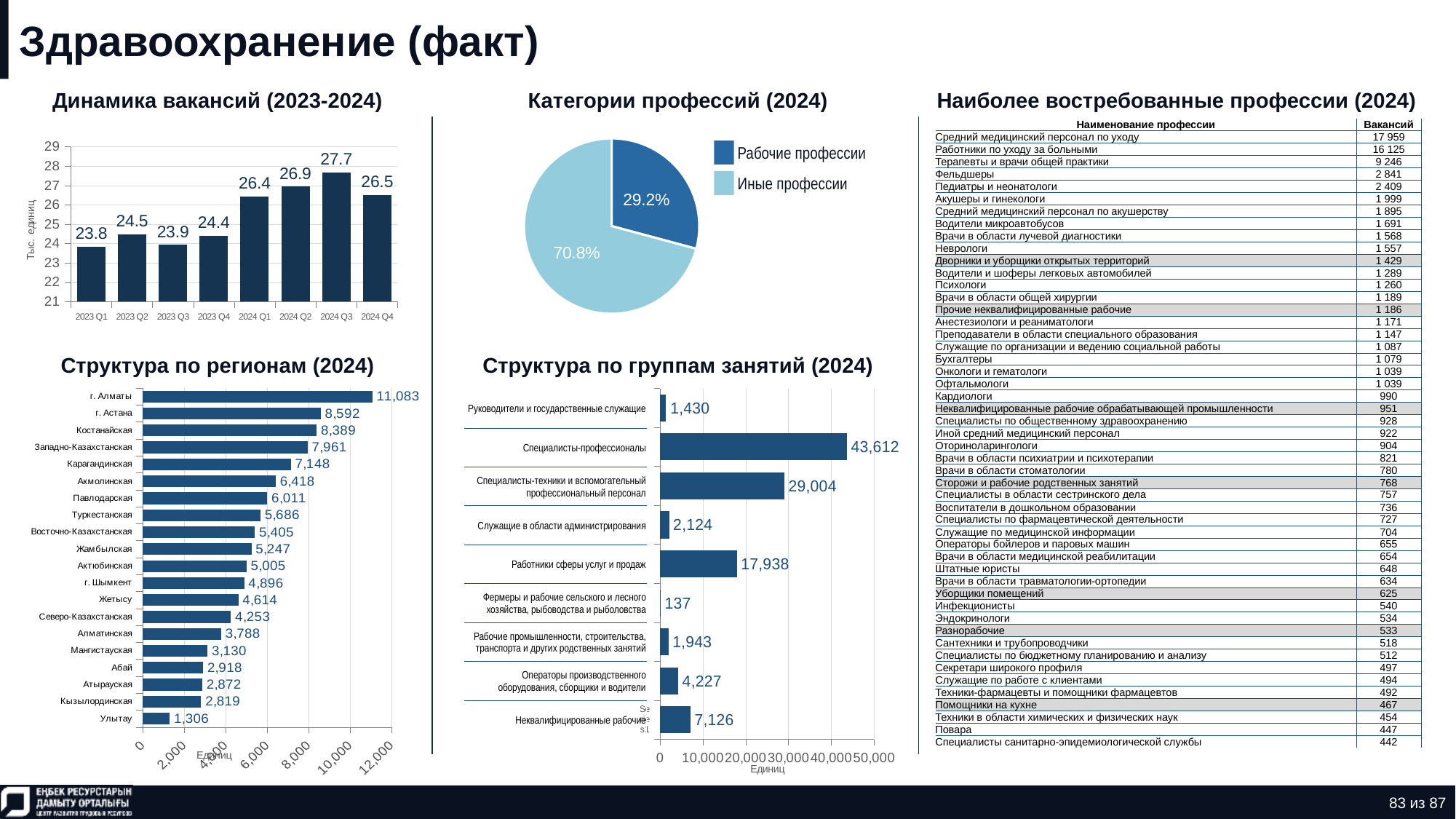
What kind of chart is 'Категории профессий (2024)'? Pie chart In the chart 'Динамика вакансий (2023-2024)', what is the difference between 2024 Q3 and 2023 Q1? 3.9 In the chart 'Динамика вакансий (2023-2024)', how many quarters are plotted? 8 In the chart 'Категории профессий (2024)', what share of the pie is 'Иные профессии'? 70.8% In the chart 'Структура по регионам (2024)', which region has the highest value? г. Алматы What kind of chart is 'Структура по группам занятий (2024)'? Bar chart In the chart 'Динамика вакансий (2023-2024)', which quarter has the lowest value? 2023 Q1 In the chart 'Структура по регионам (2024)', which region has the lowest value? Улытау In the chart 'Структура по группам занятий (2024)', which is larger: 'Специалисты-профессионалы' or 'Специалисты-техники и вспомогательный профессиональный персонал'? Специалисты-профессионалы In the chart 'Структура по регионам (2024)', what is the value for г. Астана? 8,592 In the chart 'Динамика вакансий (2023-2024)', what is the value for 2024 Q3? 27.7 In the chart 'Структура по группам занятий (2024)', what is the value for 'Работники сферы услуг и продаж'? 17,938